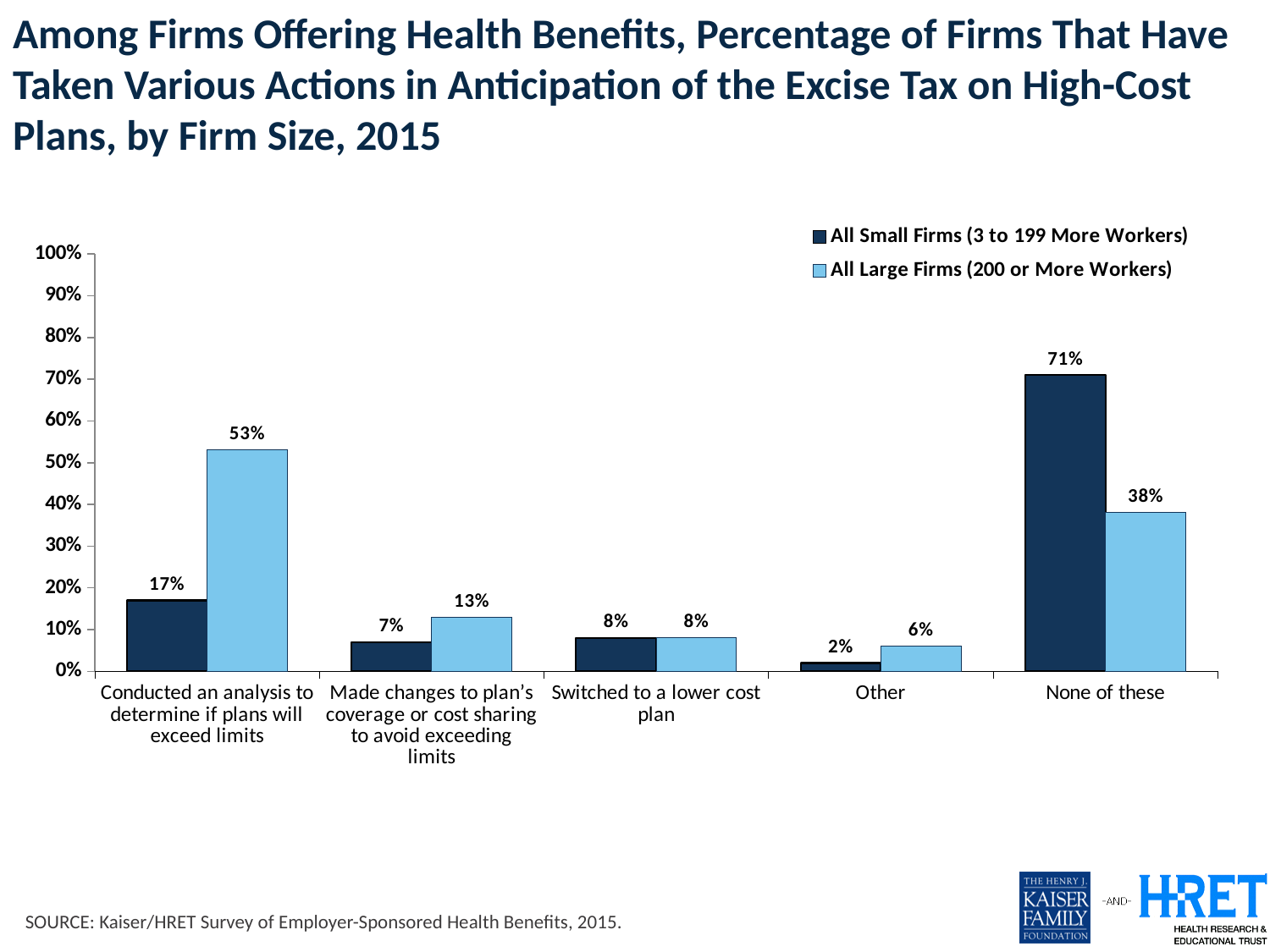
Which action category has the highest value for all small firms? None of these What percentage of all small firms answered 'Other'? 2% What is the difference between small firms and large firms for 'None of these'? 33 percentage points What percentage of all large firms conducted an analysis to determine if plans will exceed limits? 53% What kind of chart is shown on the slide? Bar chart How many action categories are shown on the x axis? 5 Which action category has the lowest value for all large firms? Other Which is larger for 'Conducted an analysis to determine if plans will exceed limits': all small firms or all large firms? All Large Firms (200 or More Workers) How many series does the legend list? 2 What percentage of all small firms conducted an analysis to determine if plans will exceed limits? 17% What is the value for both small and large firms for 'Switched to a lower cost plan'? 8% What percentage of all large firms made changes to plan's coverage or cost sharing to avoid exceeding limits? 13%